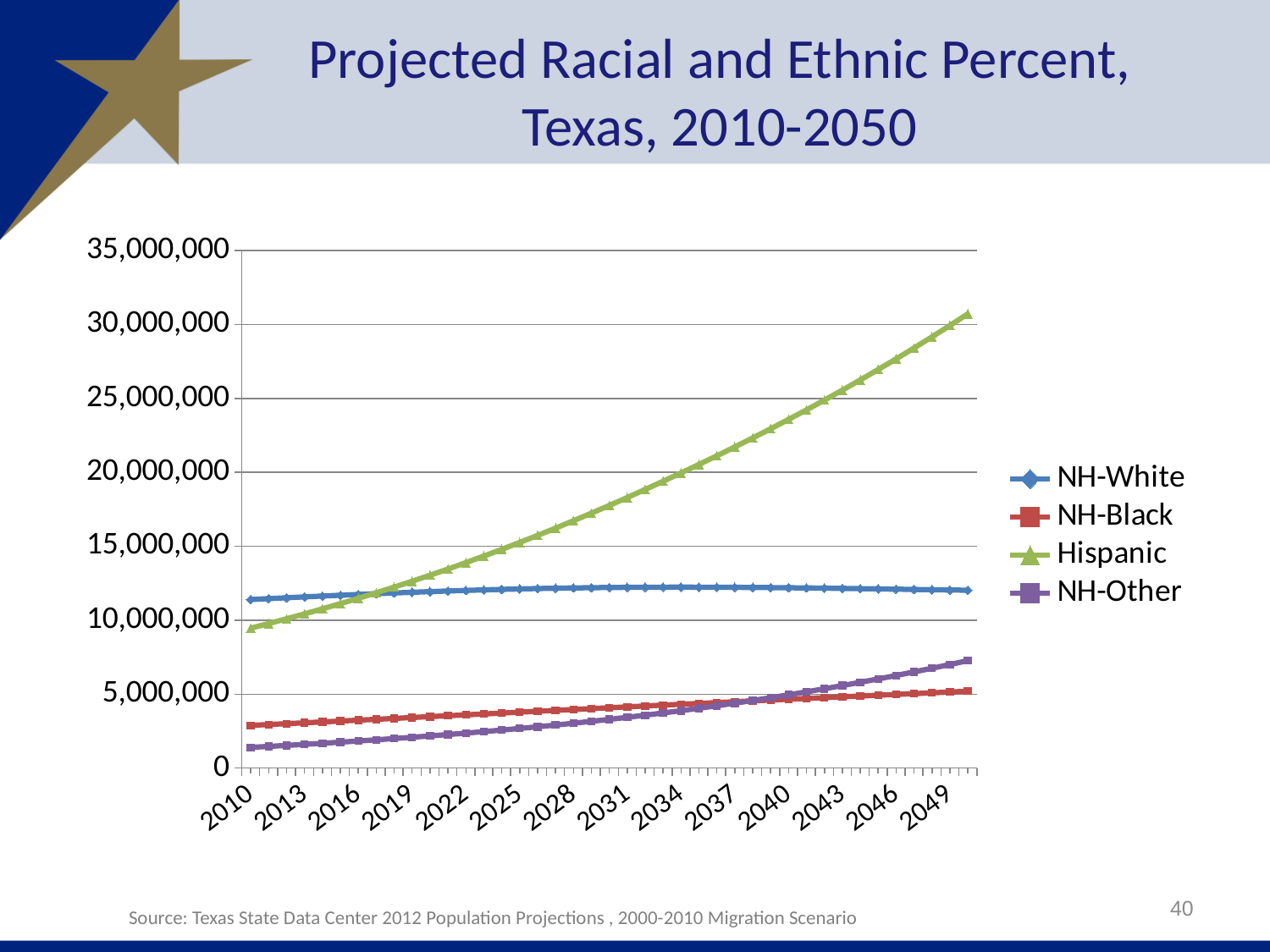
Which series has the lowest value in 2010? NH-Other How many series does the legend list? 4 What kind of chart is shown on the slide? Line chart What colour is the Hispanic line in the chart? Green In 2010, which is larger: NH-White or Hispanic? NH-White What is the title of the chart on the slide? Projected Racial and Ethnic Percent, Texas, 2010-2050 Is the value for NH-Black in 2010 greater or less than 5,000,000? less Does the Hispanic series rise or fall from 2010 to 2050? Rises Which series has the highest value in 2050? Hispanic Is the value for NH-Other in 2050 greater or less than 5,000,000? greater Is the value for Hispanic in 2050 greater or less than 25,000,000? greater In 2050, which is larger: NH-Other or NH-Black? NH-Other